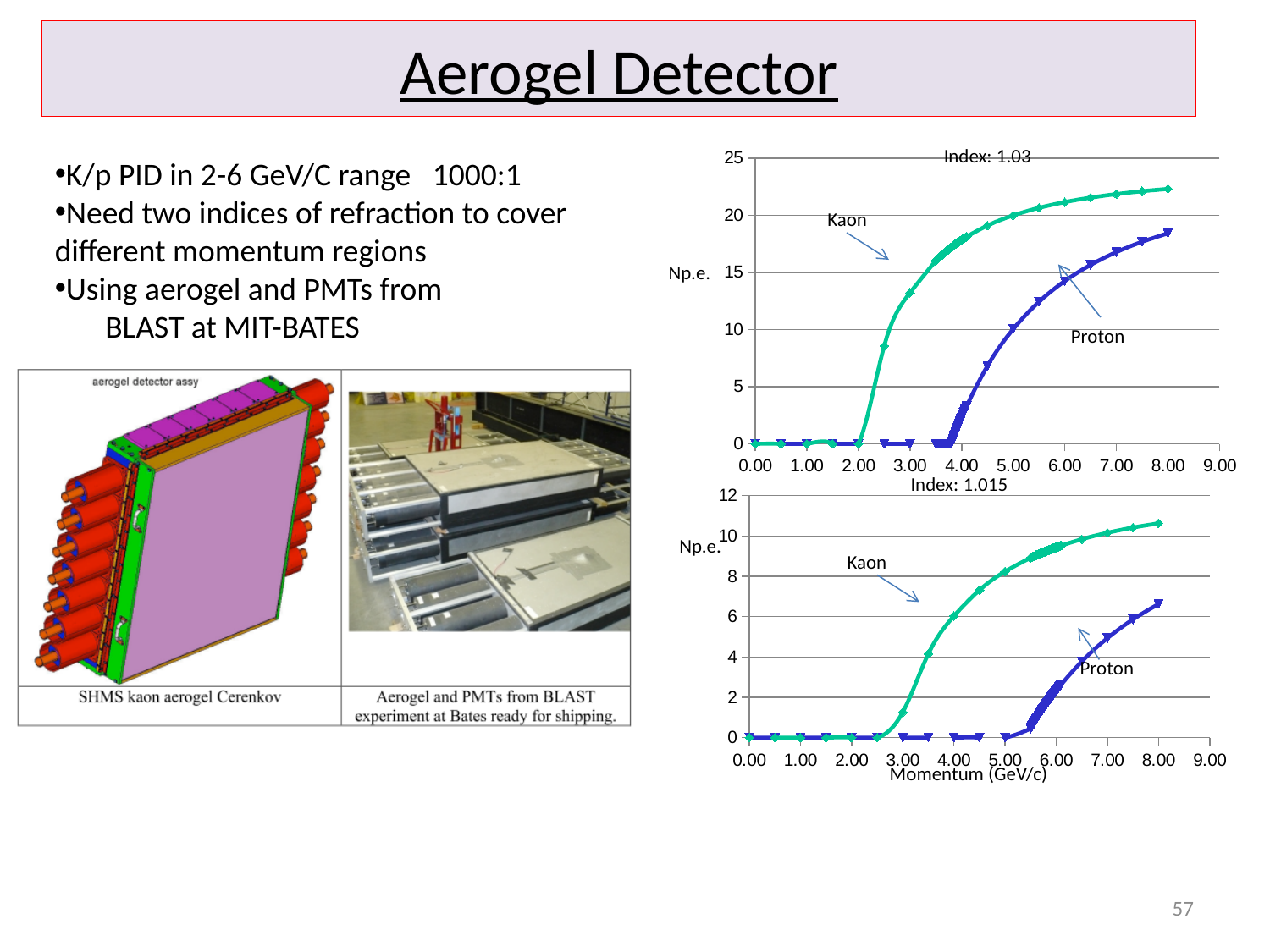
In the top chart (Index: 1.03), is the Kaon value at 8.00 GeV/c greater or less than 20? greater In the bottom chart (Index: 1.015), is the Proton value at 8.00 GeV/c greater or less than 6? greater In the top chart (Index: 1.03), is the Kaon value at 3.00 GeV/c greater or less than 10? greater In the top chart (Index: 1.03), at 6.00 GeV/c, which series has the larger Np.e. value, Kaon or Proton? Kaon In the bottom chart (Index: 1.015), at 7.00 GeV/c, which series has the larger Np.e. value, Kaon or Proton? Kaon What is the x-axis label of the bottom chart (Index: 1.015)? Momentum (GeV/c) In the top chart (Index: 1.03), does the Kaon curve rise or fall as momentum increases from 2.00 to 8.00 GeV/c? rise What kind of chart is the top chart titled "Index: 1.03"? line chart In the top chart (Index: 1.03), how many series are plotted? 2 In the top chart (Index: 1.03), which two series are labelled? Kaon and Proton